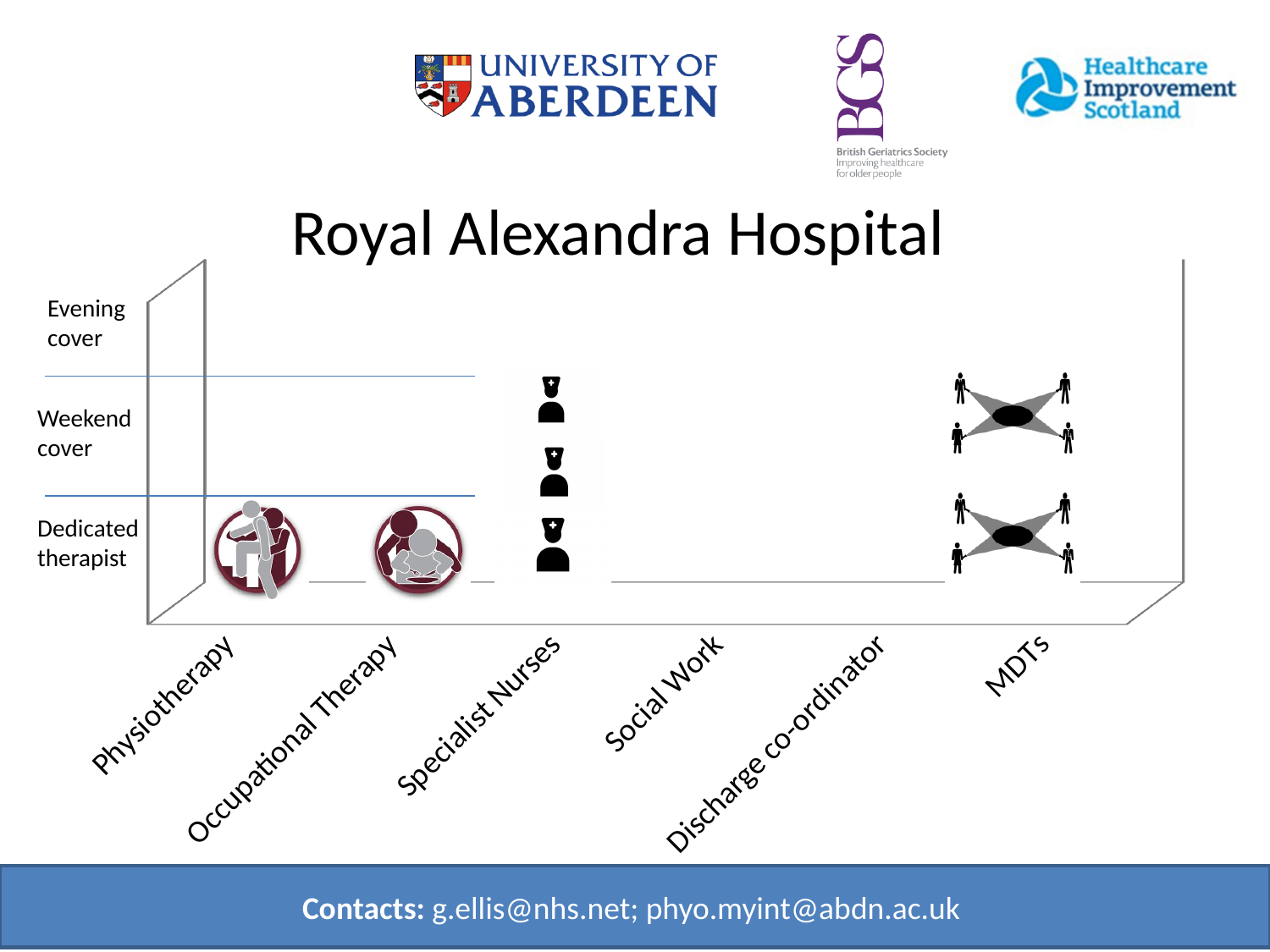
Which has more icons, Occupational Therapy or MDTs? MDTs What is the title of the chart? Royal Alexandra Hospital How many icons are stacked for MDTs? 2 What is the highest level reached by the Specialist Nurses icons? Weekend cover How many icons are stacked for Specialist Nurses? 3 How many levels are labelled on the vertical axis of the chart? 3 How many categories are shown along the x axis of the chart? 6 How many icons are shown for Physiotherapy? 1 Which categories have no icons at all in the chart? Social Work and Discharge co-ordinator What is the label of the lowest level on the vertical axis? Dedicated therapist What is the highest level reached by the MDTs icons? Weekend cover Which category has the most icons stacked in the chart? Specialist Nurses